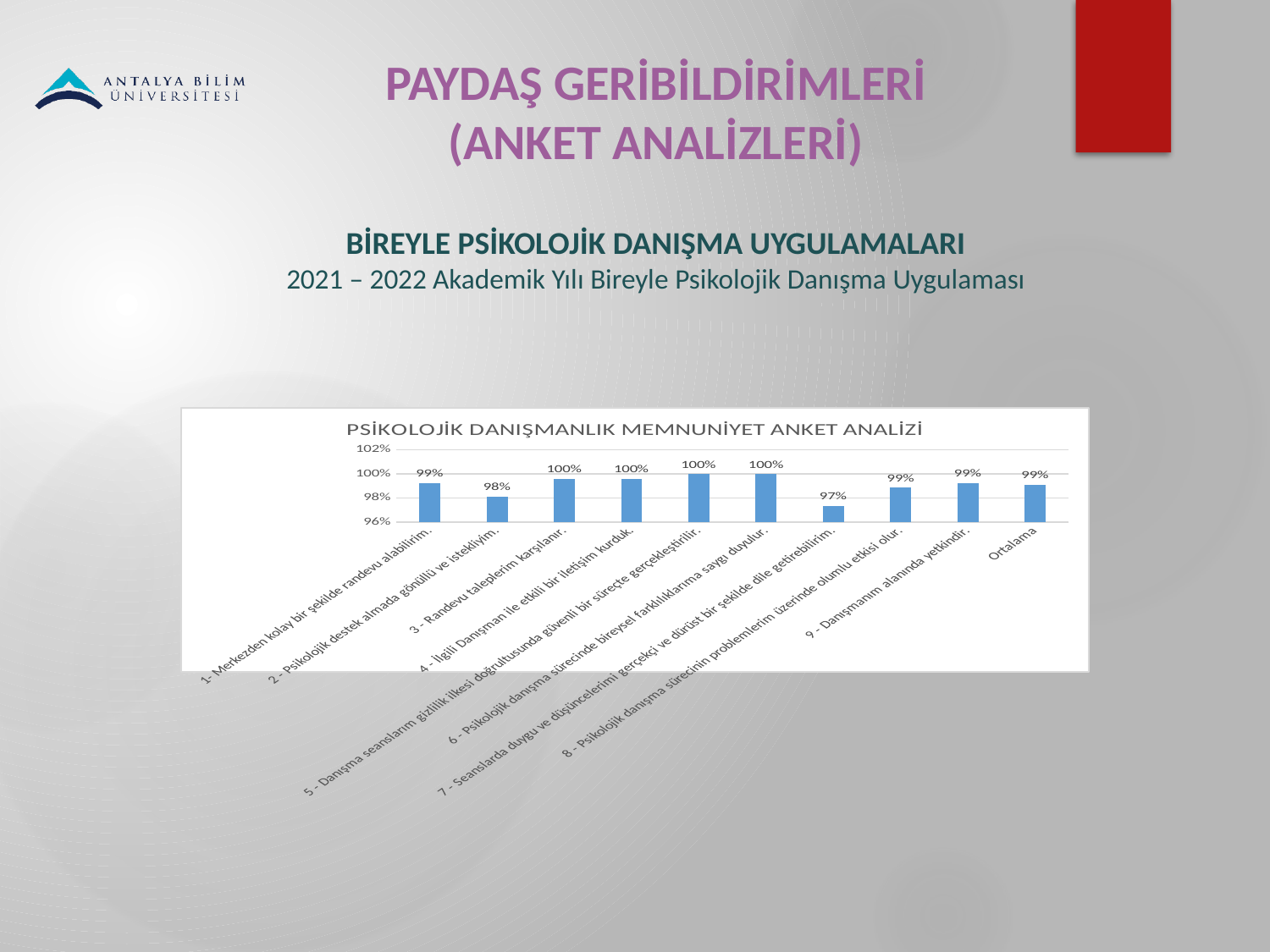
How many categories are shown on the x axis? 10 What is the value for "3 - Randevu taleplerim karşılanır."? 100% What is the value for "Ortalama"? 99% Which is larger: the value for "1- Merkezden kolay bir şekilde randevu alabilirim." or the value for "2- Psikolojik destek almada gönüllü ve istekliyim."? 1- Merkezden kolay bir şekilde randevu alabilirim. How many categories have a value of 100%? 4 What is the title of the chart? PSİKOLOJİK DANIŞMANLIK MEMNUNİYET ANKET ANALİZİ What is the value for "7 - Seanslarda duygu ve düşüncelerimi gerçekçi ve dürüst bir şekilde dile getirebilirim."? 97% Which category has the lowest value? 7 - Seanslarda duygu ve düşüncelerimi gerçekçi ve dürüst bir şekilde dile getirebilirim. What is the difference between the value for "3 - Randevu taleplerim karşılanır." and the value for "7 - Seanslarda duygu ve düşüncelerimi gerçekçi ve dürüst bir şekilde dile getirebilirim."? 3% What kind of chart is shown? bar chart What is the value for "2- Psikolojik destek almada gönüllü ve istekliyim."? 98% Is the value for "9 - Danışmanım alanında yetkindir." greater or less than 98%? greater